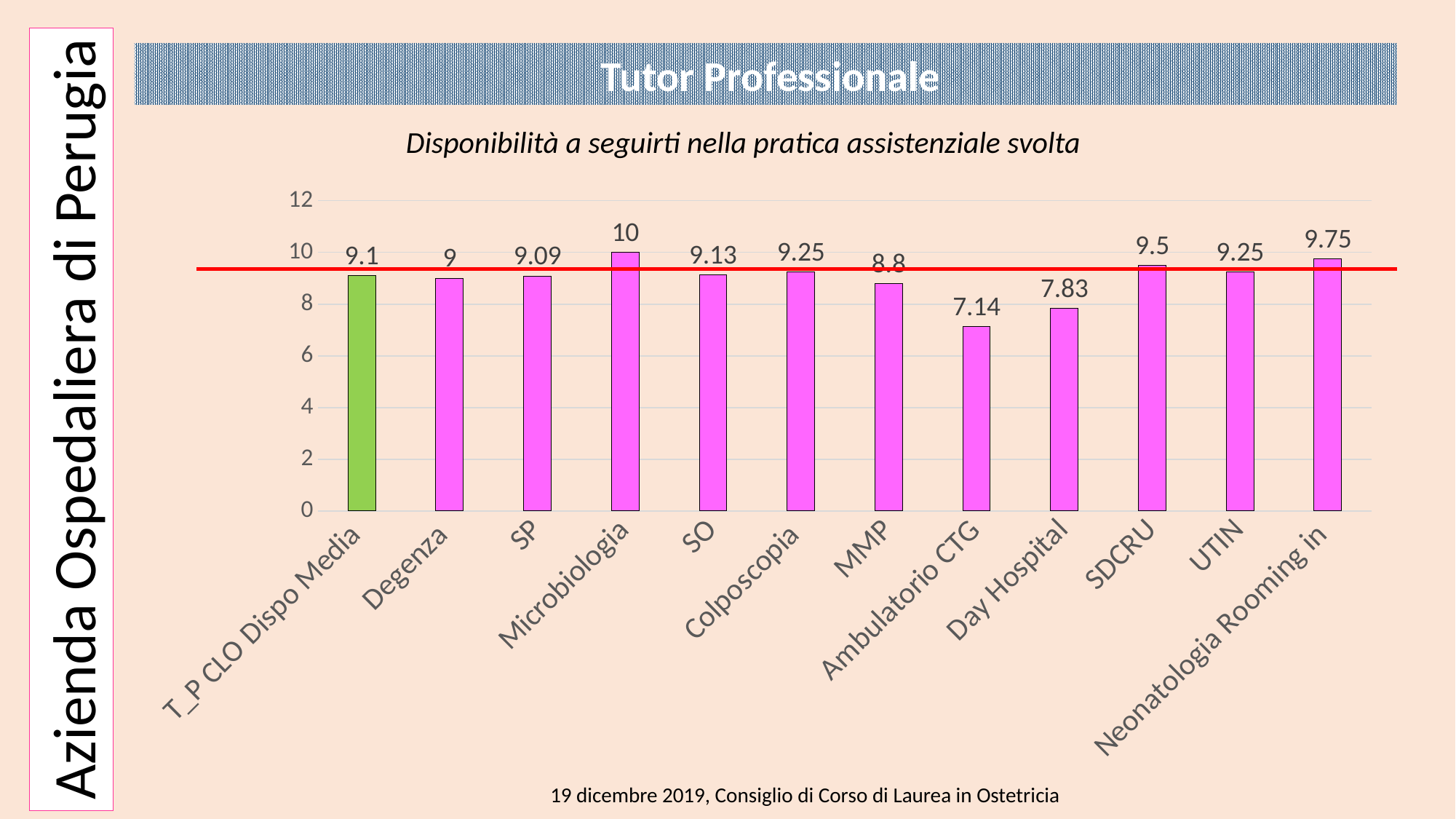
What is the value for Microbiologia? 10 What is the value for Neonatologia Rooming in? 9.75 What is the value for Ambulatorio CTG? 7.14 What kind of chart is shown on the slide? bar chart How many categories are shown on the x axis? 12 What is the value for T_P CLO Dispo Media? 9.1 Which is larger, the value for SDCRU or the value for Day Hospital? SDCRU What is the subtitle of the chart? Disponibilità a seguirti nella pratica assistenziale svolta Which category has the highest value? Microbiologia What is the difference between the values for Microbiologia and Ambulatorio CTG? 2.86 Which category has the lowest value? Ambulatorio CTG Is the value for MMP greater or less than 8? greater